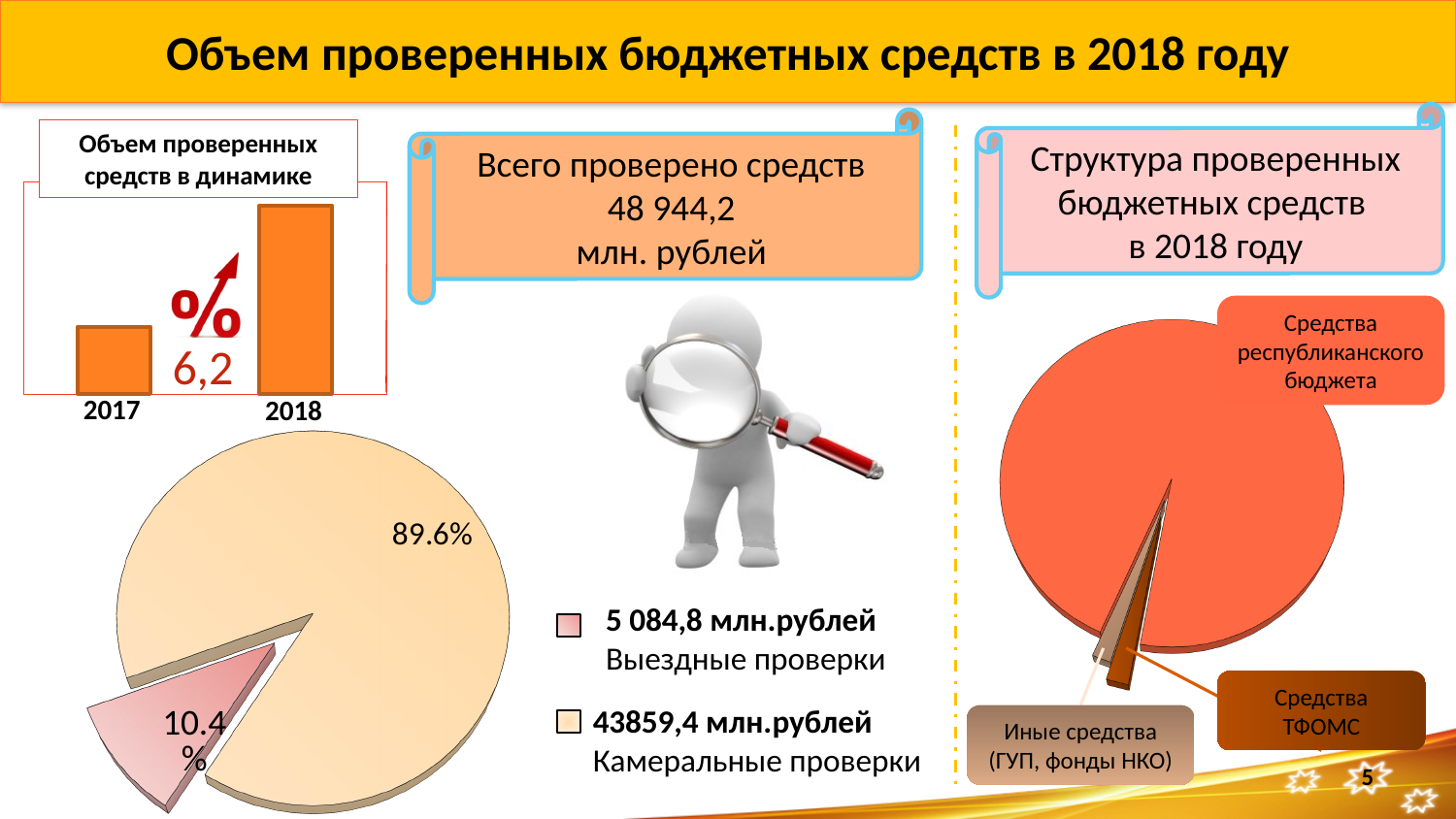
In the pie chart in the lower left of the slide, what share is labelled on the smaller, pulled-out slice? 10.4% What kind of chart is the chart in the lower left of the slide showing 89.6% and 10.4%? pie chart What kind of chart is the chart titled "Объем проверенных средств в динамике"? bar chart In the pie chart in the lower left of the slide, what value does the legend give for Выездные проверки? 5 084,8 млн.рублей In the pie chart in the lower left of the slide, what share is labelled on the larger slice? 89.6% In the pie chart titled "Структура проверенных бюджетных средств в 2018 году", which category has the largest slice? Средства республиканского бюджета In the chart "Объем проверенных средств в динамике", which year has the taller bar, 2017 or 2018? 2018 In the chart "Объем проверенных средств в динамике", do the values rise or fall from 2017 to 2018? rise How many slices does the pie chart titled "Структура проверенных бюджетных средств в 2018 году" have? 3 In the pie chart in the lower left of the slide, which category is larger, Выездные проверки or Камеральные проверки? Камеральные проверки In the pie chart in the lower left of the slide, what value does the legend give for Камеральные проверки? 43859,4 млн.рублей In the chart "Объем проверенных средств в динамике", how many years are shown on the x axis? 2